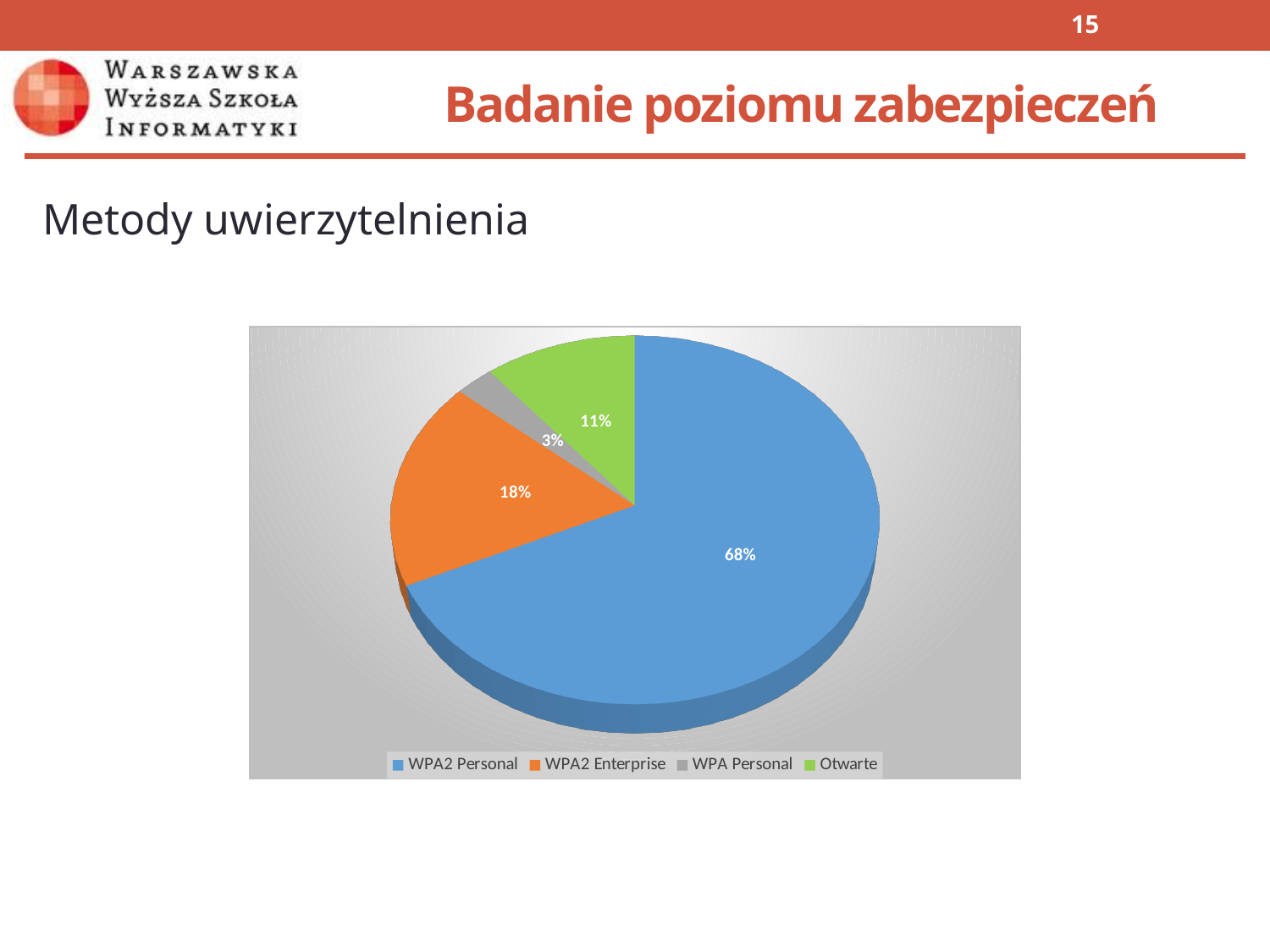
What kind of chart is shown on the slide? Pie chart Which category has the largest slice of the pie? WPA2 Personal How many categories does the pie chart show? 4 What share of the pie does Otwarte have? 11% What share of the pie does WPA2 Personal have? 68% What is the difference in percentage points between WPA2 Personal and WPA2 Enterprise? 50 Which is larger, the share for Otwarte or the share for WPA Personal? Otwarte What is the heading above the chart? Metody uwierzytelnienia Which category has the smallest slice of the pie? WPA Personal What colour is the slice for WPA2 Enterprise? Orange What share of the pie does WPA2 Enterprise have? 18% What share of the pie does WPA Personal have? 3%